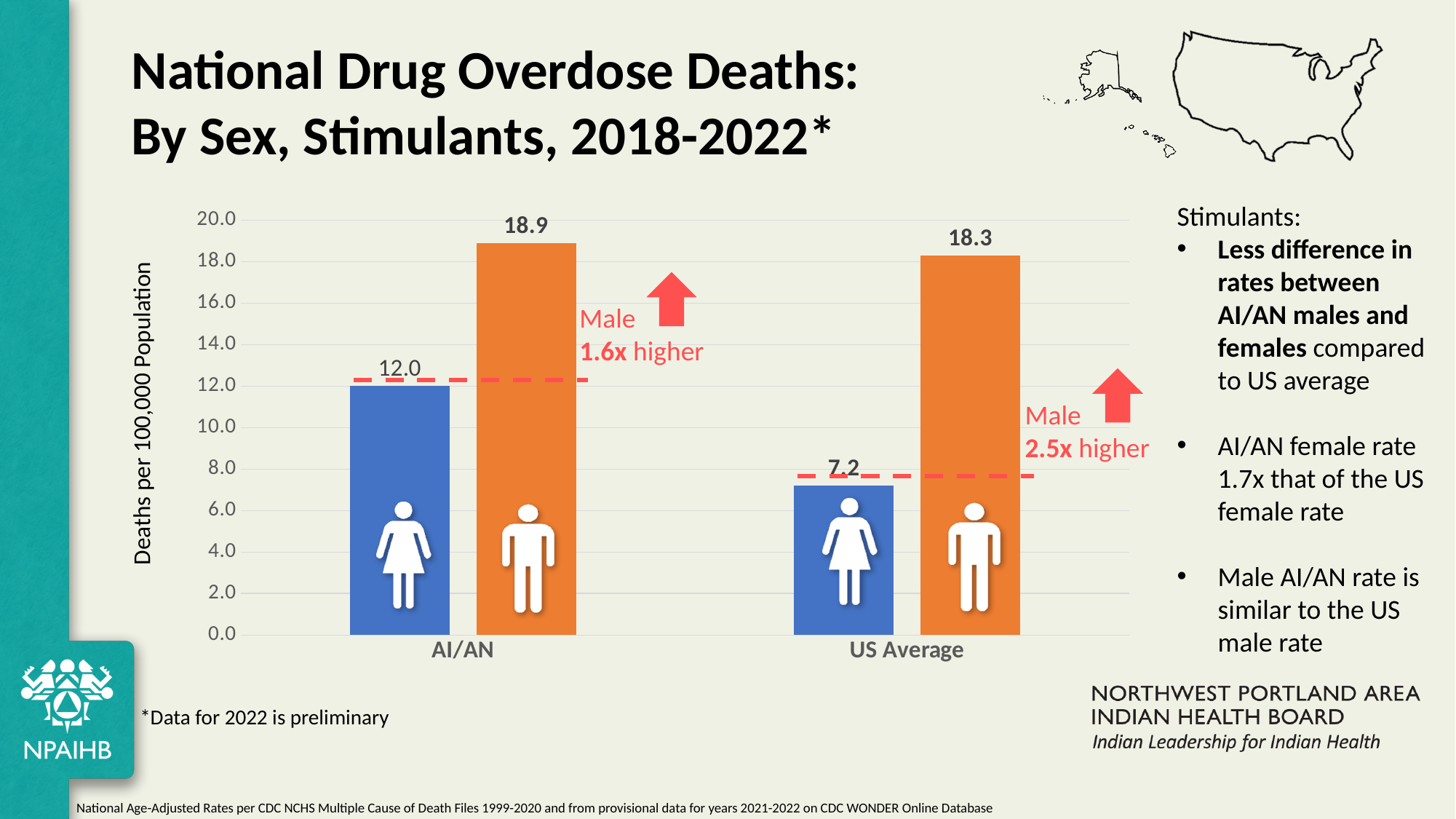
What is the label of the y axis of the chart? Deaths per 100,000 Population What is the difference between the AI/AN male rate and the AI/AN female rate? 6.9 Which bar on the chart has the lowest value? US Average female (7.2) What is the male stimulant overdose death rate for the US Average shown on the chart? 18.3 What is the female stimulant overdose death rate for AI/AN shown on the chart? 12.0 How many categories are shown on the x axis of the chart? 2 Which is larger, the AI/AN female rate or the US Average female rate? AI/AN female rate Which bar on the chart has the highest value? AI/AN male (18.9) What is the difference between the AI/AN female rate and the US Average female rate? 4.8 What is the female stimulant overdose death rate for the US Average shown on the chart? 7.2 What type of chart is shown on the slide? Bar chart What is the male stimulant overdose death rate for AI/AN shown on the chart? 18.9